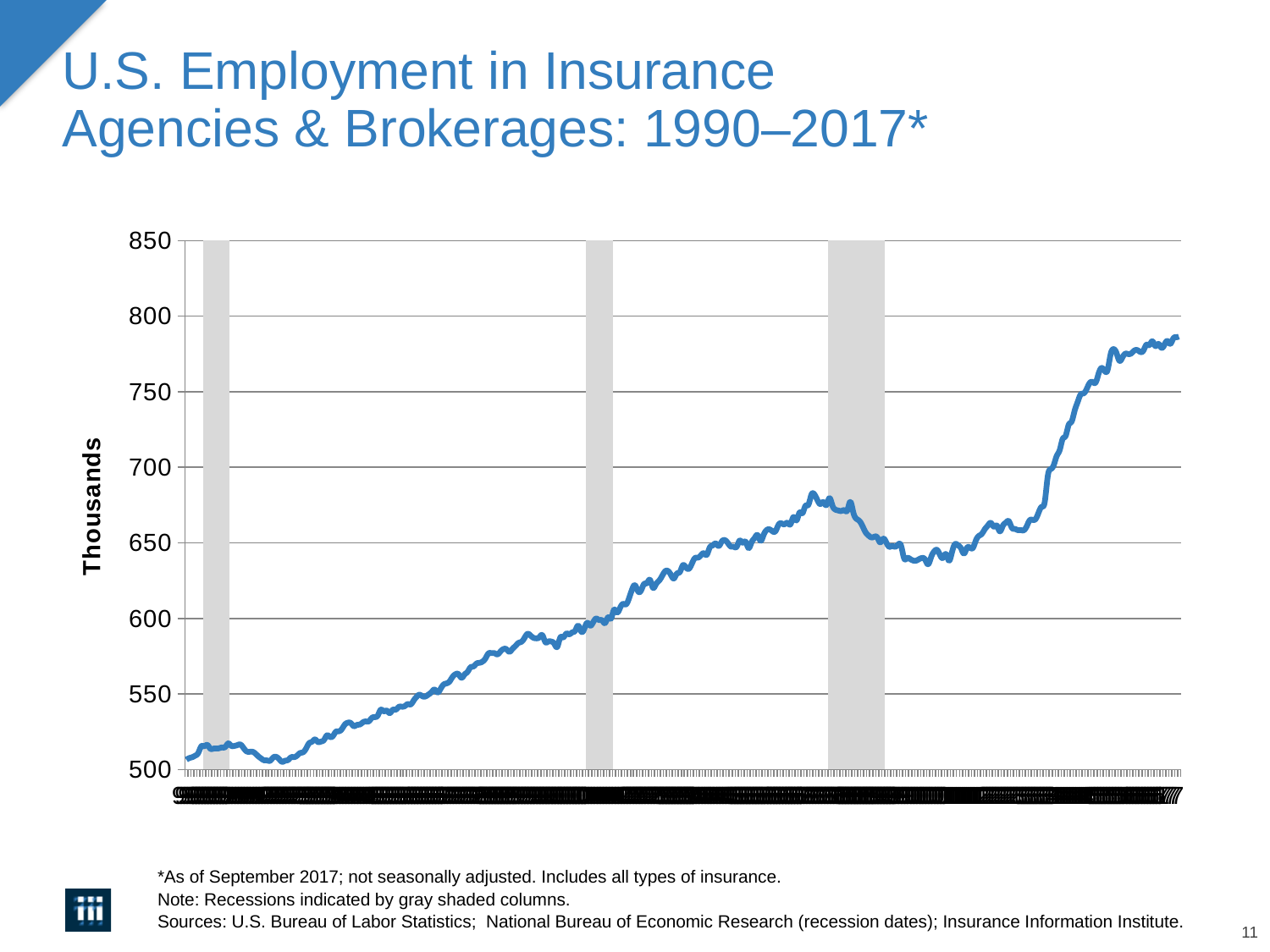
How many gray shaded recession columns appear on the chart? 3 What is the highest value shown on the vertical axis? 850 Is the value at the end of the series (September 2017) greater or less than 750? greater Overall, does employment rise or fall from the start of the series in 1990 to the end in 2017? rise Which is larger: the value at the start of the series (1990) or the value at the end of the series (2017)? the value at the end (2017) Is the peak reached just before the third gray shaded recession column greater or less than 700? less Is the lowest point of the line after the third gray shaded recession column greater or less than 600? greater What is the label on the vertical axis of the chart? Thousands What kind of chart is shown on the slide? line chart What is the title of the chart? U.S. Employment in Insurance Agencies & Brokerages: 1990–2017*